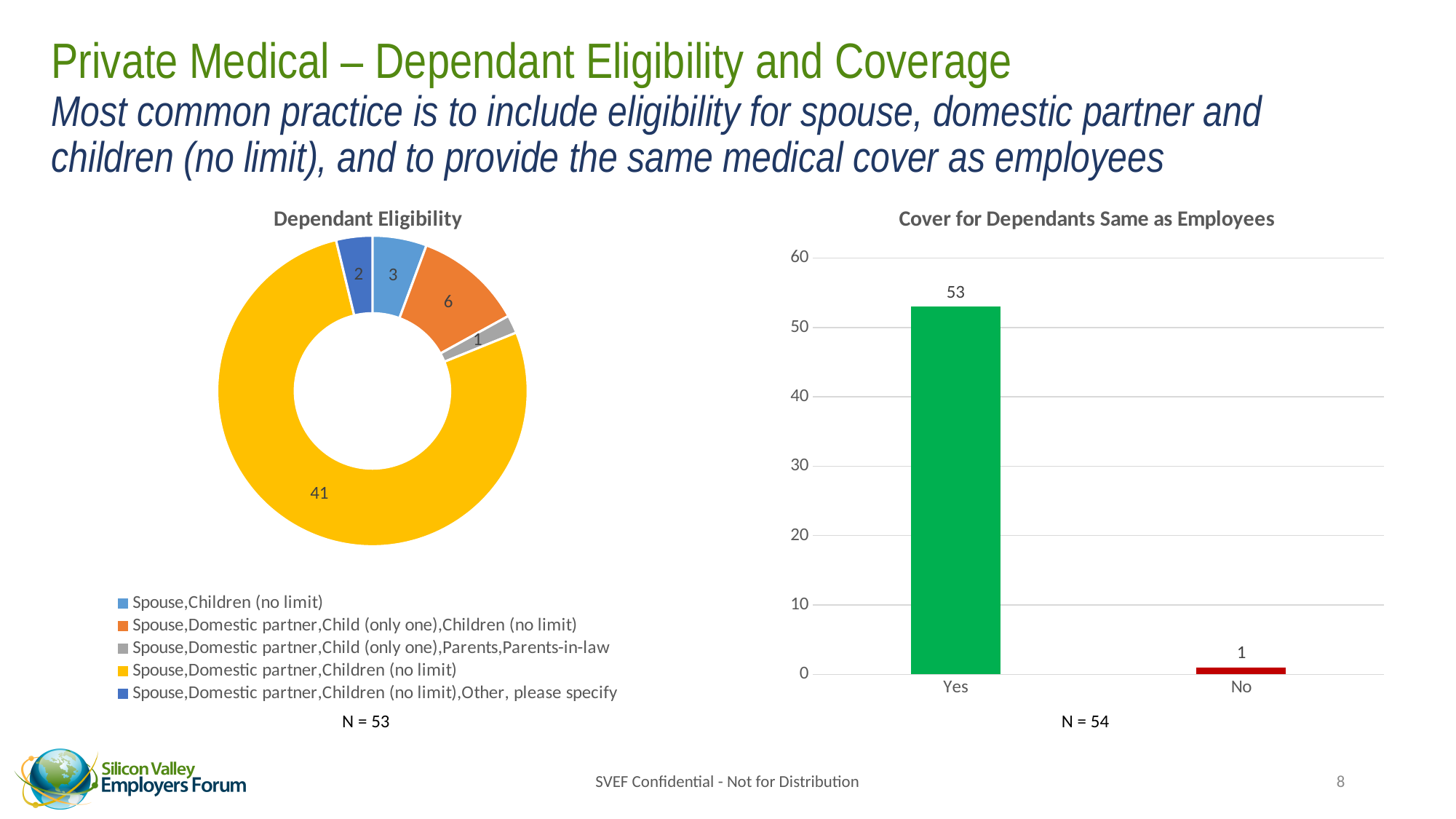
In the 'Dependant Eligibility' chart, what is the value for 'Spouse,Domestic partner,Child (only one),Children (no limit)'? 6 What kind of chart is the 'Cover for Dependants Same as Employees' chart? Bar chart In the 'Dependant Eligibility' chart, which category has the largest value? Spouse,Domestic partner,Children (no limit) In the 'Dependant Eligibility' chart, how many respondents chose 'Spouse,Domestic partner,Children (no limit)'? 41 In the 'Dependant Eligibility' chart, how many categories does the legend list? 5 In the 'Cover for Dependants Same as Employees' chart, what colour is the 'Yes' bar? Green In the 'Cover for Dependants Same as Employees' chart, what is the value for 'No'? 1 In the 'Cover for Dependants Same as Employees' chart, what is the value for 'Yes'? 53 What kind of chart is the 'Dependant Eligibility' chart? Doughnut chart In the 'Dependant Eligibility' chart, what is the difference between the values for 'Spouse,Children (no limit)' and 'Spouse,Domestic partner,Children (no limit),Other, please specify'? 1 In the 'Dependant Eligibility' chart, which category has the smallest value? Spouse,Domestic partner,Child (only one),Parents,Parents-in-law In the 'Cover for Dependants Same as Employees' chart, what is the difference between the 'Yes' and 'No' values? 52